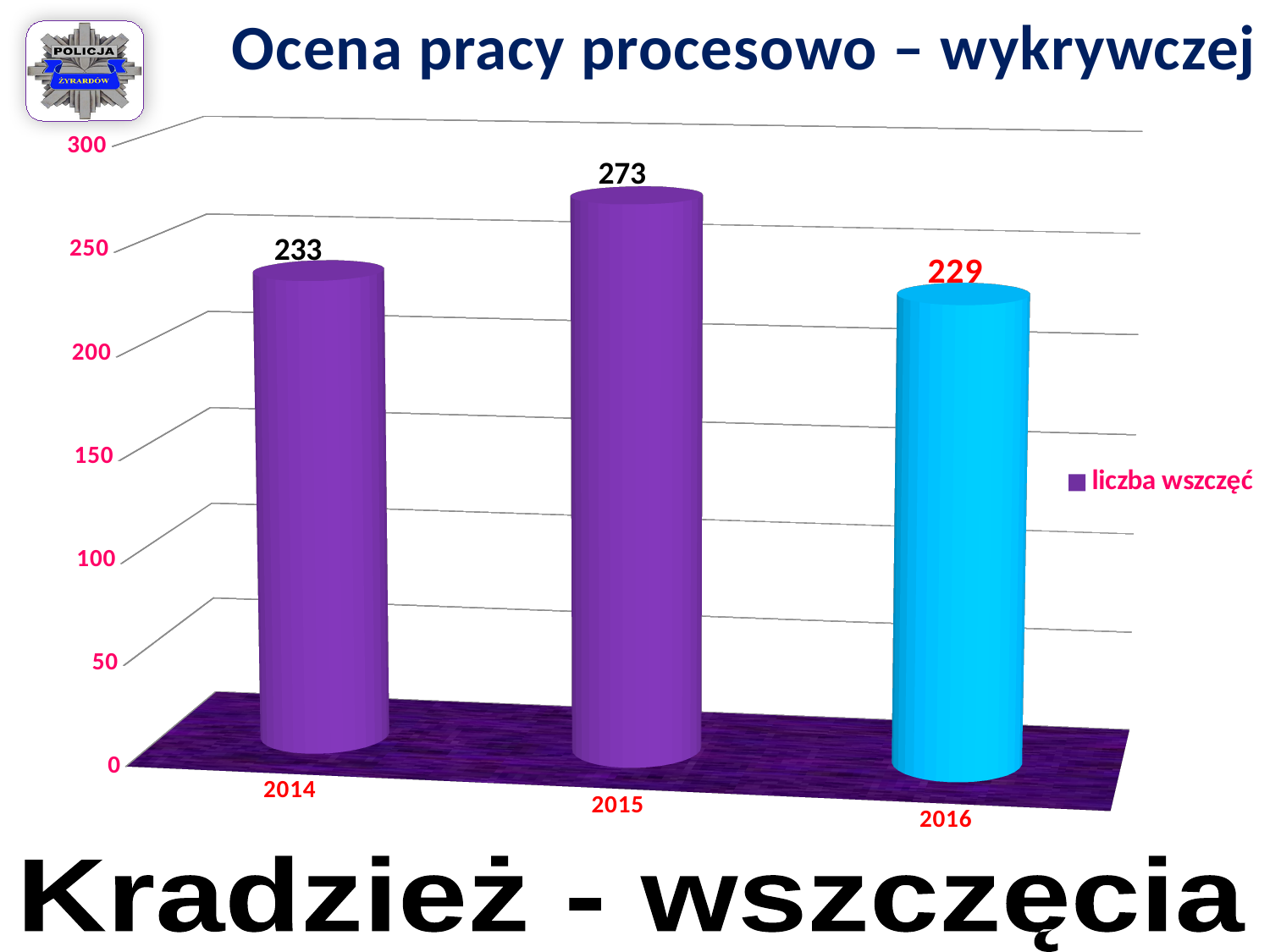
Which is larger, the value for 2015 or the value for 2016? 2015 How many years are shown on the x axis? 3 What is the difference between the values for 2014 and 2016? 4 What is the value for 2014? 233 Which year has the lowest value? 2016 What is the value for 2016? 229 What kind of chart is shown on the slide? bar chart What is the legend entry shown on the chart? liczba wszczęć Is the value for 2015 greater or less than 250? greater What is the difference between the values for 2015 and 2014? 40 Which year has the highest value? 2015 What is the value for 2015? 273